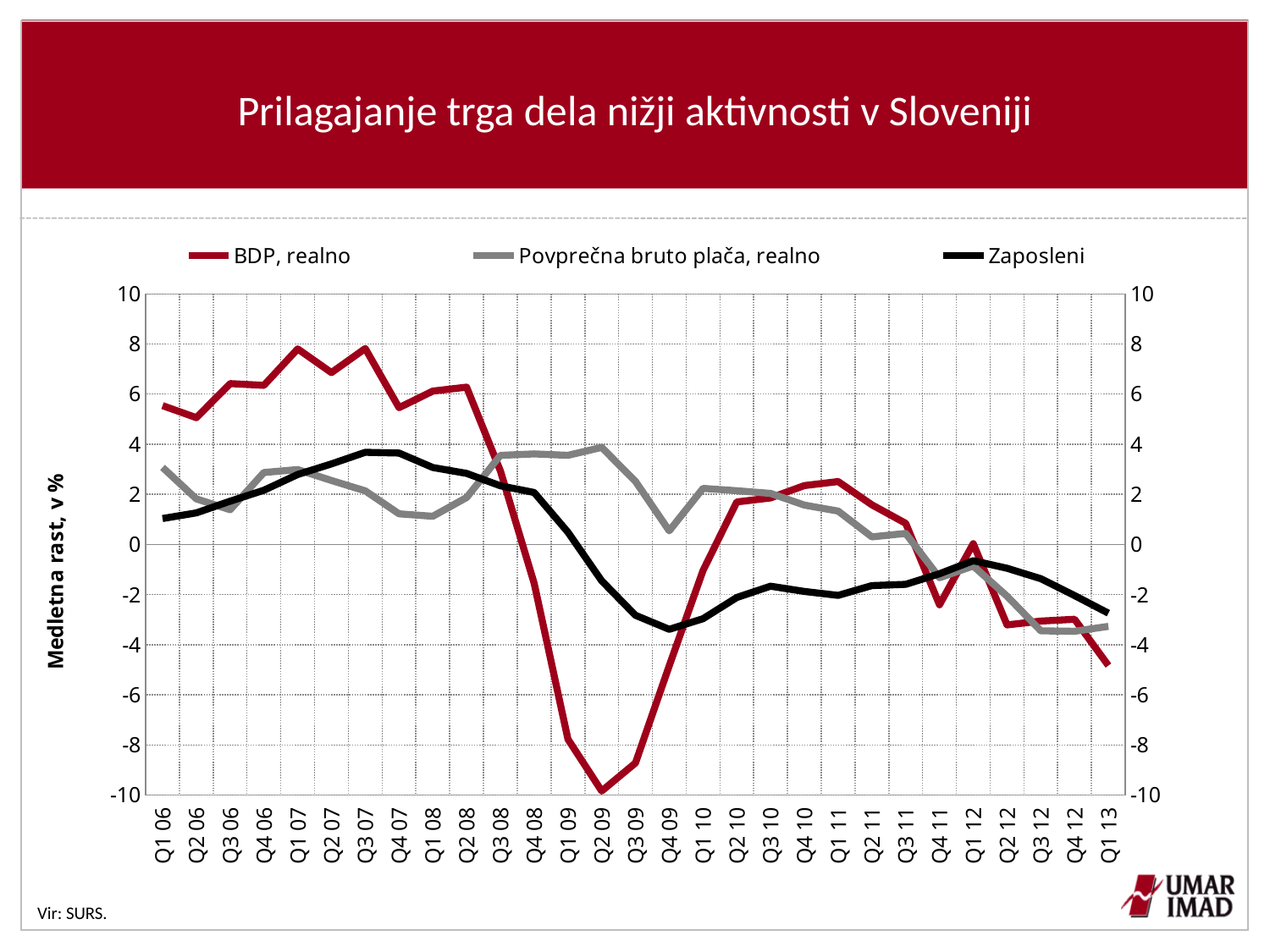
In which quarter does BDP, realno reach its lowest value? Q2 09 What is the title of the y axis? Medletna rast, v % At Q1 09, which is higher: BDP, realno or Zaposleni? Zaposleni Is the value for BDP, realno at Q2 09 greater or less than -8? less How many series does the legend list? 3 Is the value for Zaposleni at Q4 09 greater or less than -2? less How many quarters are shown along the x axis? 29 At Q1 13, which is higher: BDP, realno or Zaposleni? Zaposleni What kind of chart is shown on the slide? line chart Is the value for BDP, realno at Q3 07 greater or less than 6? greater Does BDP, realno rise or fall from Q2 08 to Q2 09? fall